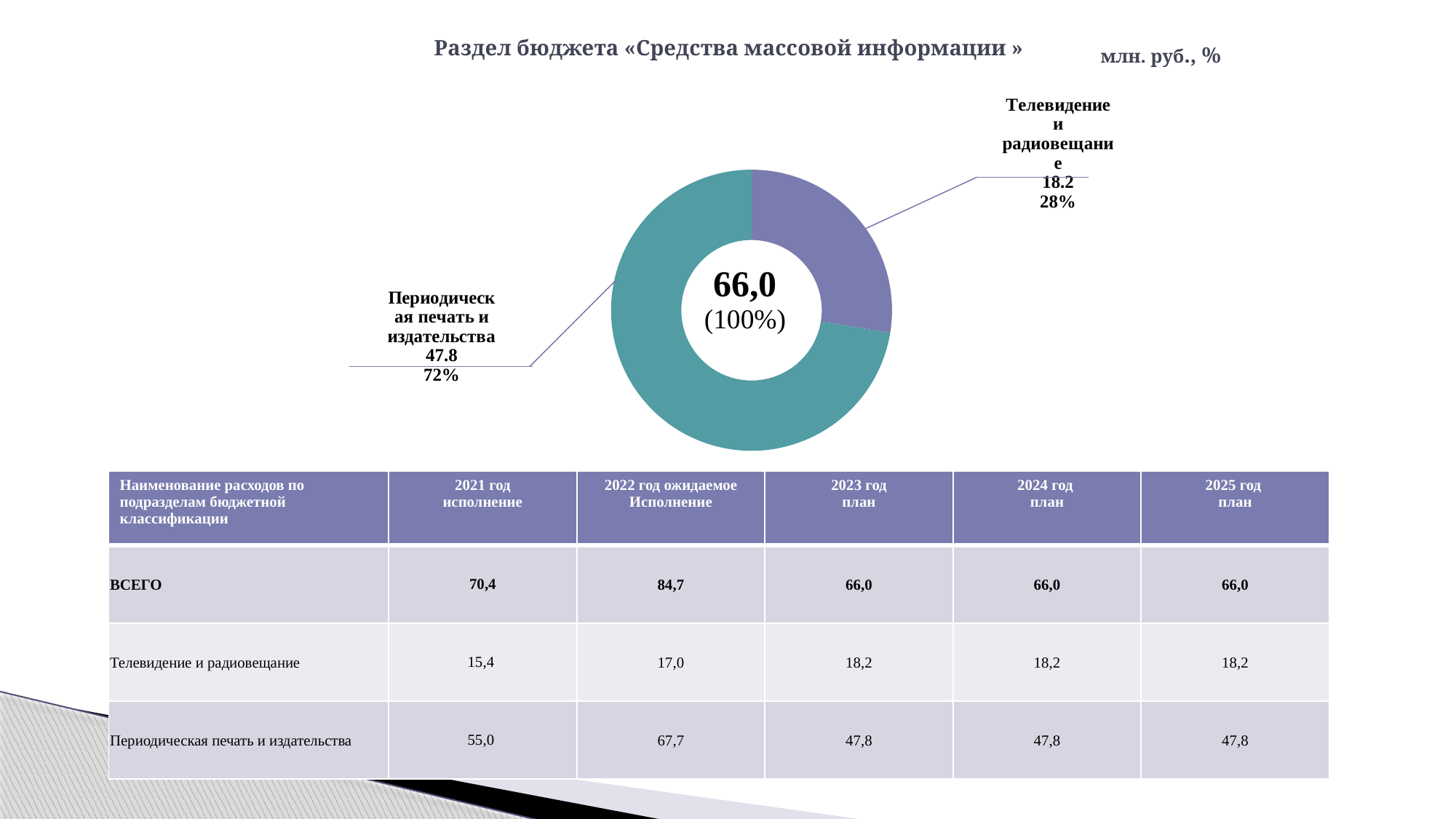
Which slice of the pie chart is the largest? Периодическая печать и издательства What share of the pie does "Периодическая печать и издательства" take? 72% Which slice of the pie chart is the smallest? Телевидение и радиовещание How many slices does the pie chart have? 2 What is the value shown for the slice "Периодическая печать и издательства"? 47.8 What is the title of the chart on the slide? Раздел бюджета «Средства массовой информации » What is the value shown for the slice "Телевидение и радиовещание"? 18.2 Which is larger: the value for "Телевидение и радиовещание" or for "Периодическая печать и издательства"? Периодическая печать и издательства What share of the pie does "Телевидение и радиовещание" take? 28% What total value is shown in the centre of the donut chart? 66,0 (100%) What is the difference between the values for "Периодическая печать и издательства" and "Телевидение и радиовещание"? 29.6 What kind of chart is shown on the slide? Pie chart (donut)